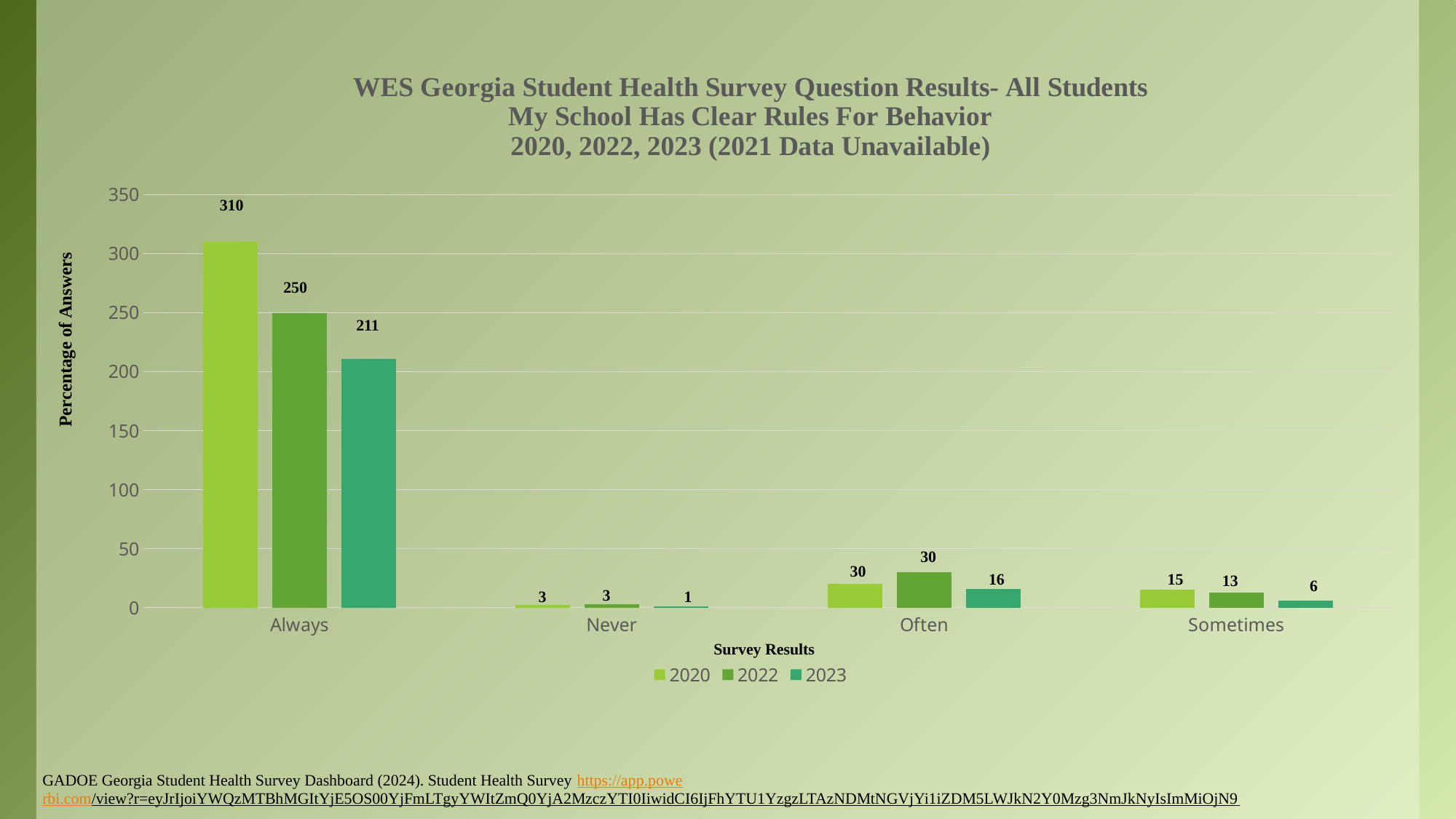
What is the difference between the 2020 and 2023 values in the Always category? 99 What is the value for 2023 in the Often category? 16 How many categories are shown on the x axis? 4 Is the value for 2022 in the Always category greater or less than 200? greater How many series does the legend list? 3 Which is larger in the Sometimes category, the 2020 value or the 2023 value? 2020 Which category has the highest value for the 2022 series? Always What is the value for 2020 in the Always category? 310 What is the label of the y axis? Percentage of Answers What kind of chart is shown on the slide? bar chart What is the value for 2022 in the Sometimes category? 13 Which category has the lowest value for the 2023 series? Never